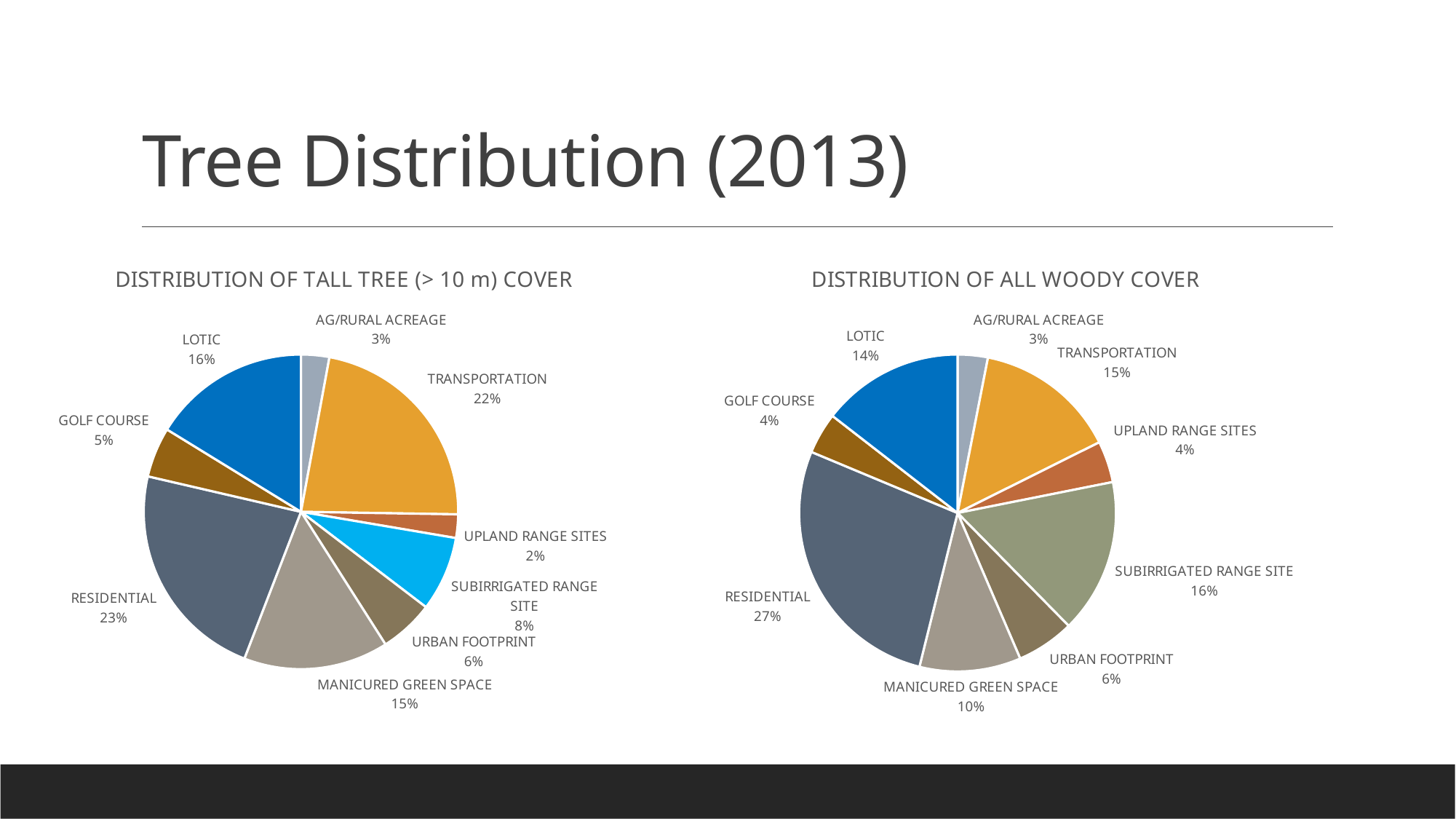
In the 'Distribution of Tall Tree (> 10 m) Cover' chart, what share does Subirrigated Range Site have? 8% In the 'Distribution of Tall Tree (> 10 m) Cover' chart, which is larger: Lotic or Manicured Green Space? Lotic In the 'Distribution of All Woody Cover' chart, what share does Residential have? 27% In the 'Distribution of Tall Tree (> 10 m) Cover' chart, what share does Transportation have? 22% In the 'Distribution of Tall Tree (> 10 m) Cover' chart, which category has the smallest share? Upland Range Sites In the 'Distribution of All Woody Cover' chart, which category has the smallest share? Ag/Rural Acreage What type of chart is the 'Distribution of Tall Tree (> 10 m) Cover' chart? Pie chart In the 'Distribution of All Woody Cover' chart, what is the difference between the Residential share and the Transportation share? 12% In the 'Distribution of All Woody Cover' chart, which category has the largest share? Residential In the 'Distribution of Tall Tree (> 10 m) Cover' chart, which category has the largest share? Residential What is the title of the chart on the right side of the slide? Distribution of All Woody Cover How many categories does the 'Distribution of All Woody Cover' pie chart show? 9